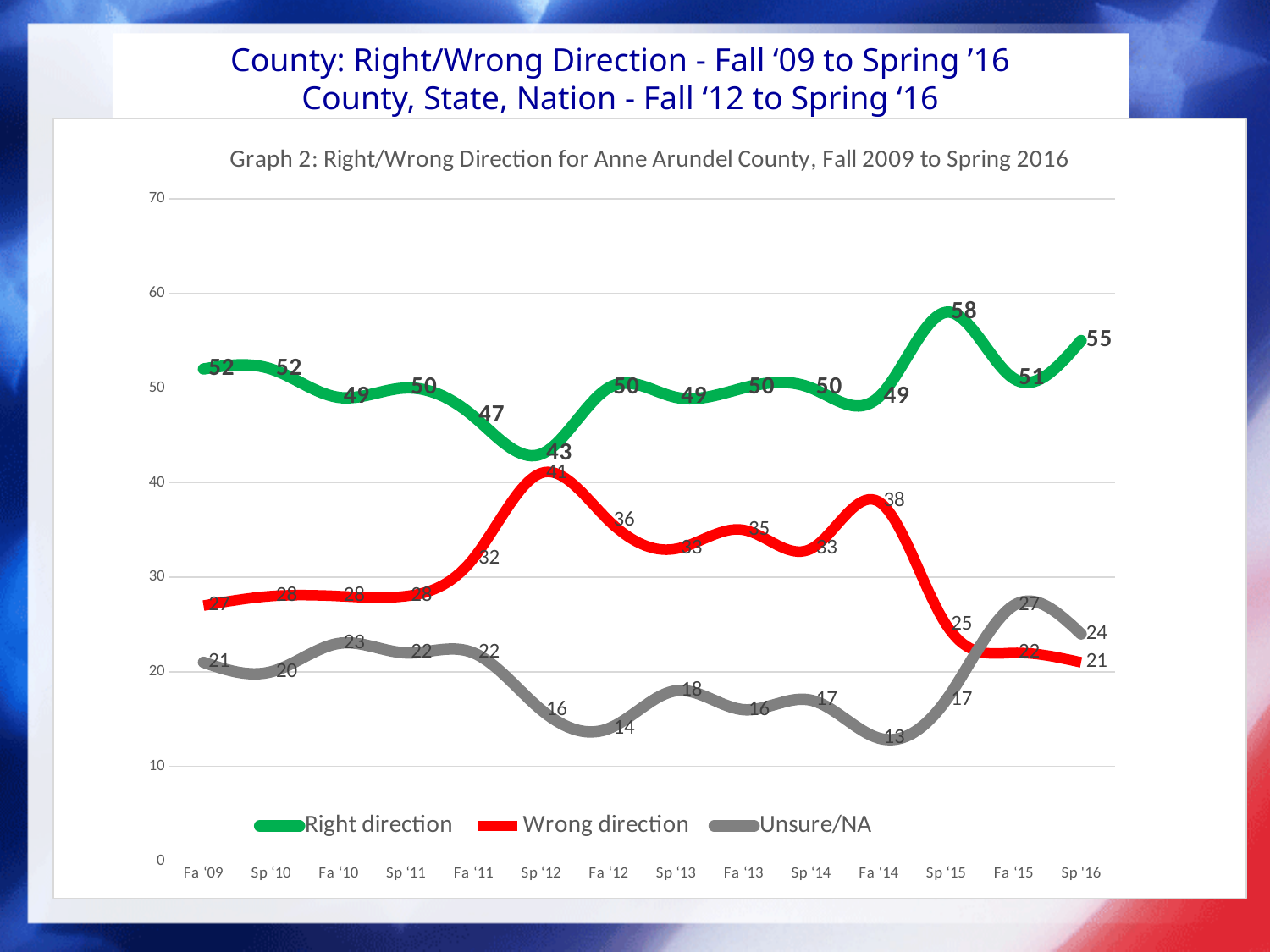
How many series does the legend list? 3 In which period is the Wrong direction value highest? Sp '12 In which period is the Right direction value highest? Sp '15 What is the Right direction value for Sp '15? 58 How many time periods are shown on the x axis? 14 What is the Wrong direction value for Sp '12? 41 What kind of chart is this? Line chart In which period is the Right direction value lowest? Sp '12 What is the difference between the Right direction and Wrong direction values in Sp '16? 34 In which period is the Unsure/NA value lowest? Fa '14 In Fa '15, which is larger: the Unsure/NA value or the Wrong direction value? Unsure/NA What is the Unsure/NA value for Fa '14? 13